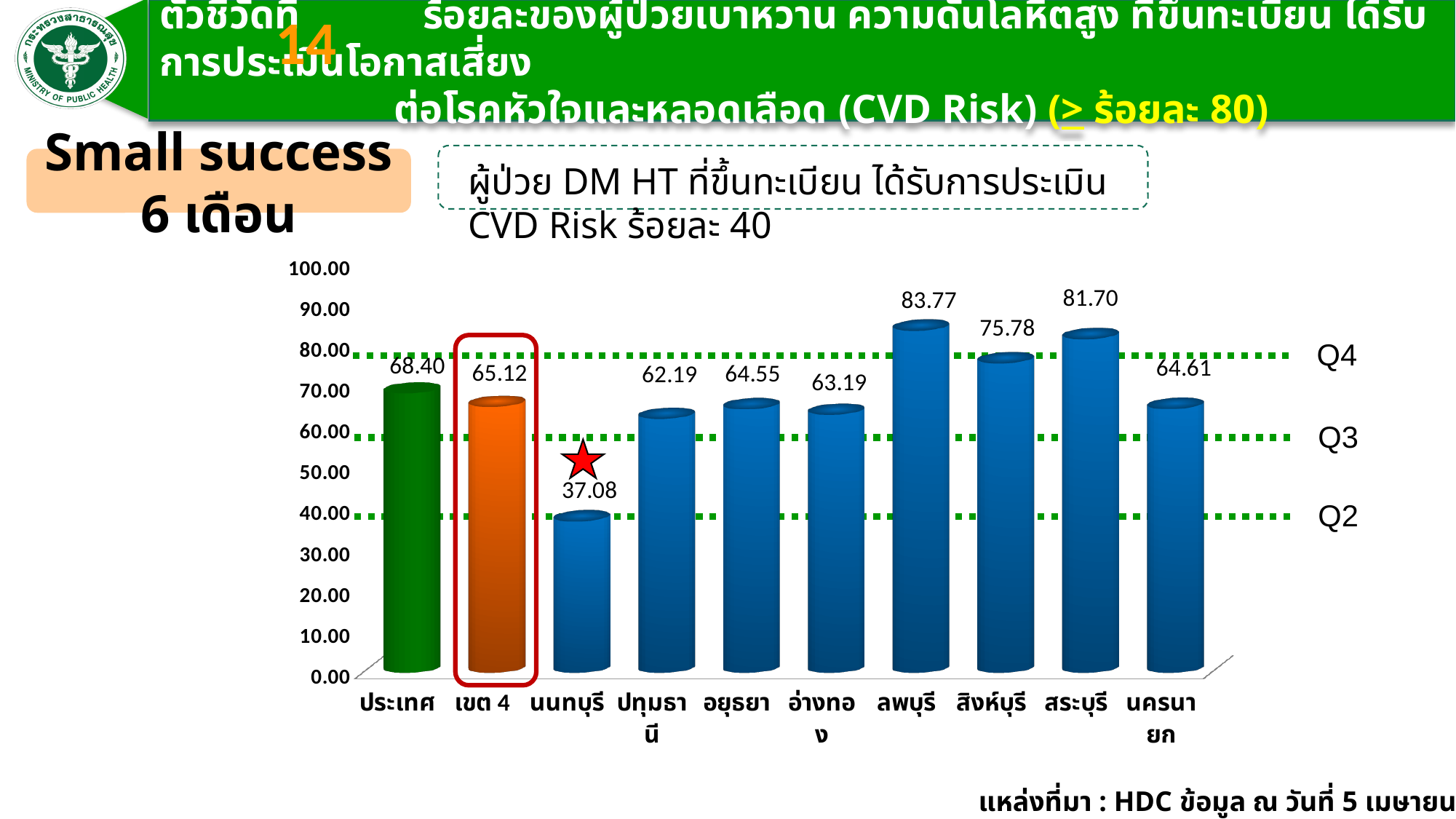
Which category has the highest value? ลพบุรี What is the value for ลพบุรี? 83.77 Which bar is highlighted with a red outline? เขต 4 What is the value for เขต 4? 65.12 What is the value for นนทบุรี? 37.08 What is the value for ประเทศ? 68.40 Which is larger, the value for สิงห์บุรี or the value for นครนายก? สิงห์บุรี What is the difference between the values for ลพบุรี and สระบุรี? 2.07 How many categories are shown on the x axis? 10 What kind of chart is shown on the slide? bar chart Is the value for สระบุรี greater or less than 80.00? greater Which category has the lowest value? นนทบุรี